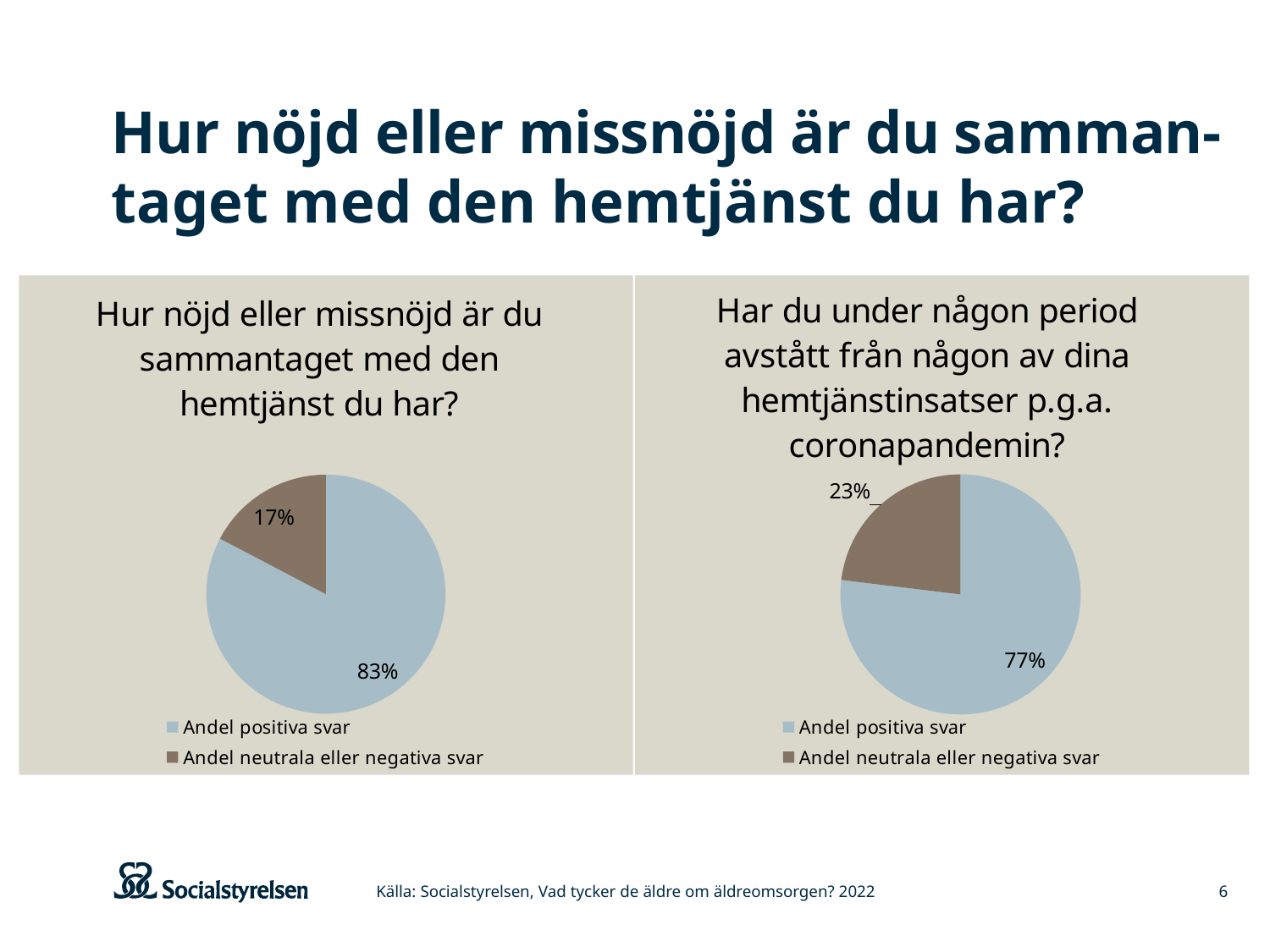
In the right chart, what share of responses is 'Andel positiva svar'? 77% In the left chart, what share of responses is 'Andel positiva svar'? 83% In the right chart, which category has the smallest slice? Andel neutrala eller negativa svar How many entries does the legend of the left chart list? 2 What type of chart is used on the left side of the slide? Pie chart How many slices does the right pie chart have? 2 In the right chart, what share of responses is 'Andel neutrala eller negativa svar'? 23% What is the title of the right chart? Har du under någon period avstått från någon av dina hemtjänstinsatser p.g.a. coronapandemin? Which chart has the larger 'Andel neutrala eller negativa svar' share, the left or the right? The right chart In the left chart, which category has the largest slice? Andel positiva svar In the left chart, what share of responses is 'Andel neutrala eller negativa svar'? 17% What is the difference between the 'Andel positiva svar' share in the left chart and in the right chart? 6 percentage points